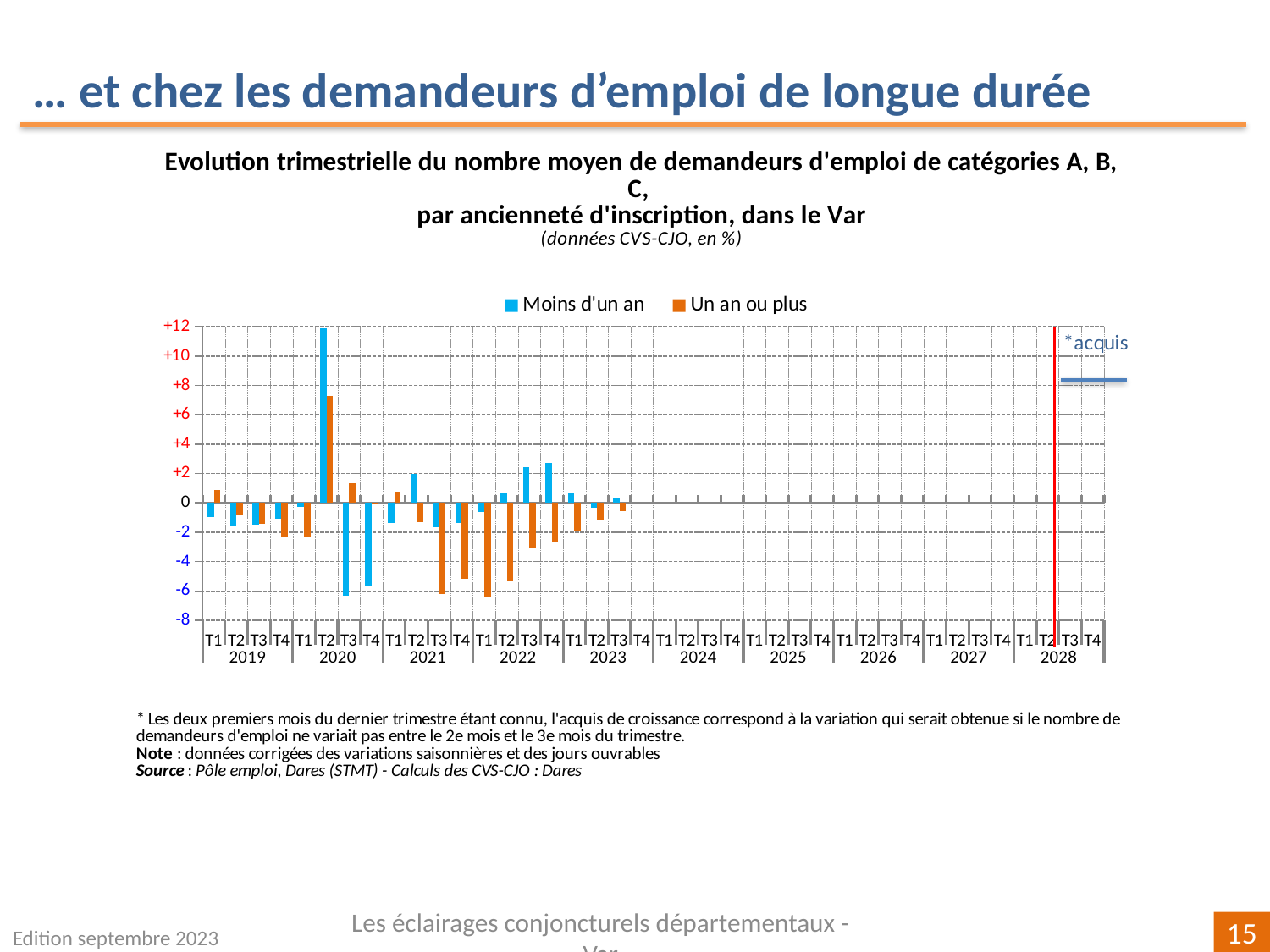
Is the value for 'Moins d'un an' in T3 2020 greater or less than -4? less Which colour represents the series 'Un an ou plus'? orange How many years are labelled along the x axis? 10 Is the value for 'Moins d'un an' in T2 2020 greater or less than +10? greater Is the value for 'Un an ou plus' in T2 2020 greater or less than +6? greater In which quarter does the 'Un an ou plus' series reach its highest value? T2 2020 In T2 2020, which series has the larger value, 'Moins d'un an' or 'Un an ou plus'? Moins d'un an How many series does the legend list? 2 What kind of chart is shown on the slide? bar chart In which quarter does the 'Moins d'un an' series reach its highest value? T2 2020 What are the two series named in the legend? Moins d'un an; Un an ou plus